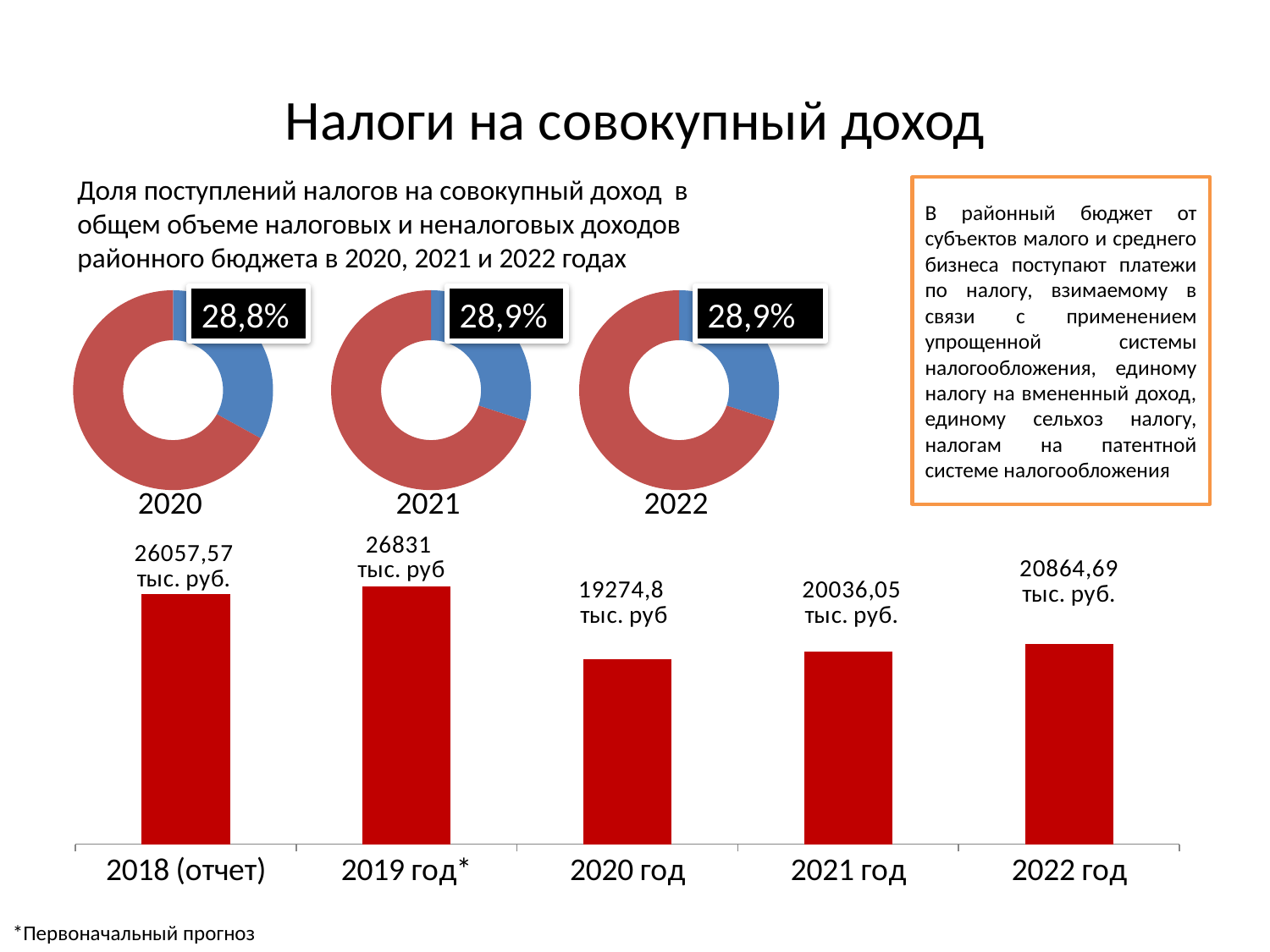
How many bars are in the bar chart at the bottom of the slide? 5 In the bar chart at the bottom of the slide, what is the difference between the values for 2022 год and 2021 год? 828,64 тыс. руб. In the bar chart at the bottom of the slide, what is the difference between the values for 2019 год* and 2018 (отчет)? 773,43 тыс. руб. In the bar chart at the bottom of the slide, which year has the lowest value? 2020 год In the bar chart at the bottom of the slide, which is larger: the value for 2021 год or 2022 год? 2022 год In the bar chart at the bottom of the slide, what is the value for 2019 год*? 26831 тыс. руб In the bar chart at the bottom of the slide, what is the value for 2020 год? 19274,8 тыс. руб What kind of chart is shown at the bottom of the slide? Bar chart In the donut chart labelled 2020, what share is shown by the data label? 28,8% In the bar chart at the bottom of the slide, which year has the highest value? 2019 год* In the bar chart at the bottom of the slide, do the values rise or fall from 2020 год to 2022 год? Rise In the bar chart at the bottom of the slide, what is the value for 2022 год? 20864,69 тыс. руб.